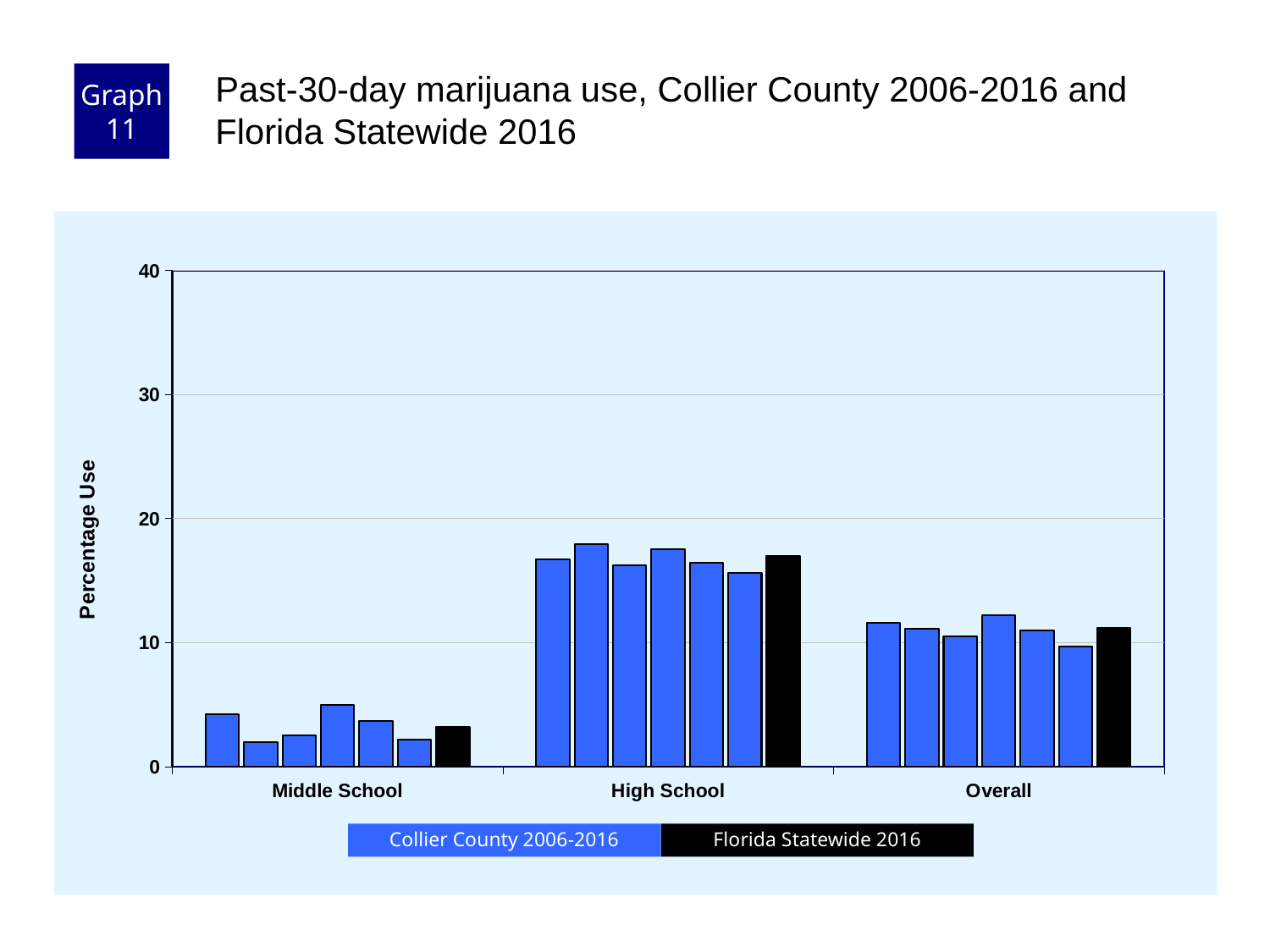
What is the label on the y axis? Percentage Use Which category has the lowest Florida Statewide 2016 value? Middle School Which category has the highest Florida Statewide 2016 value? High School Is the Florida Statewide 2016 value for Overall greater or less than 20? less How many series does the legend list? 2 What kind of chart is shown on the slide? Bar chart How many categories are shown along the x axis? 3 Is the Florida Statewide 2016 value for Middle School greater or less than 10? less Which colour represents Florida Statewide 2016 in the legend? Black Which is larger, the Florida Statewide 2016 value for High School or for Overall? High School Is the Florida Statewide 2016 value for High School greater or less than 10? greater